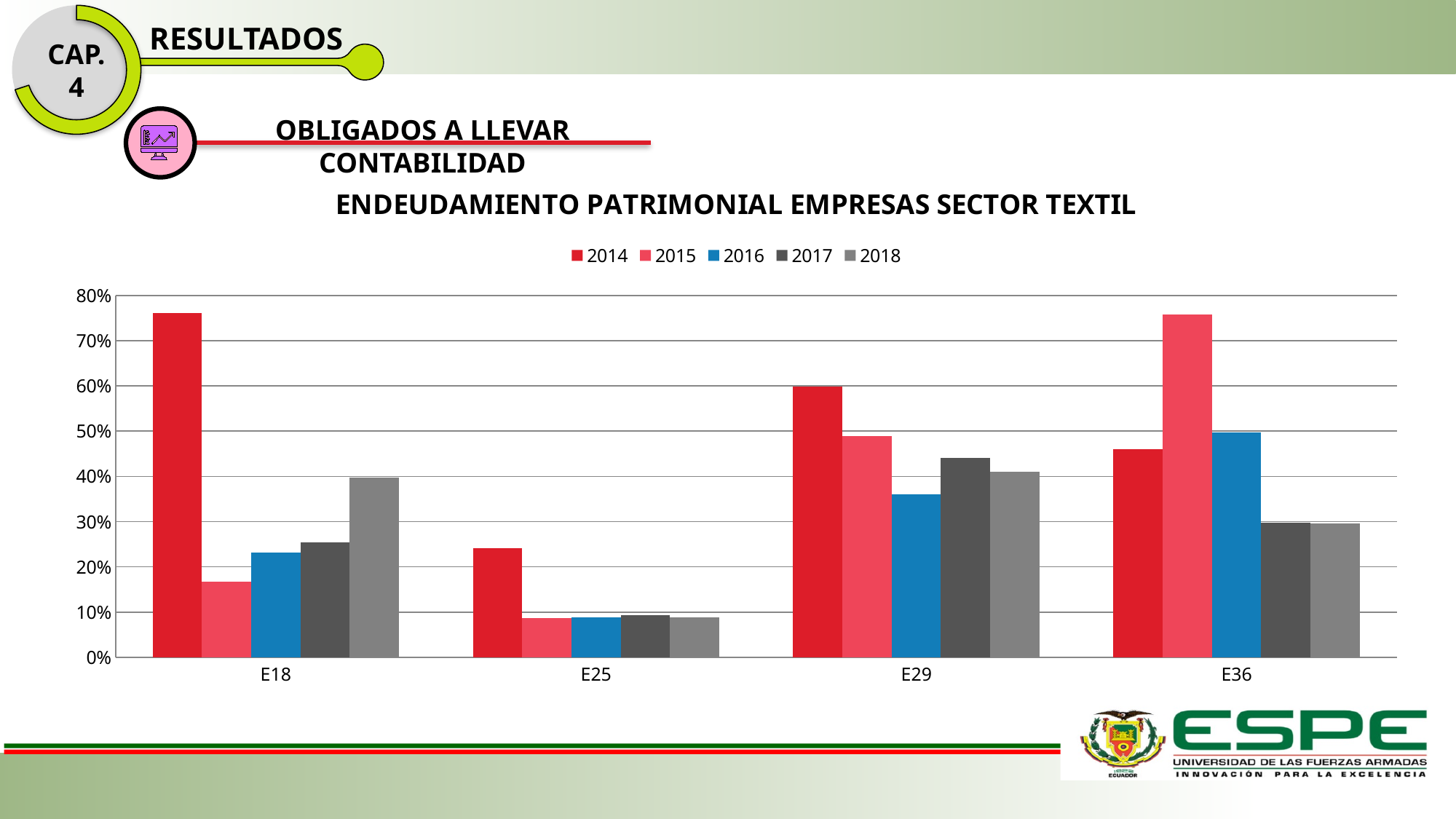
How many series does the legend list? 5 Which company has the highest 2015 value? E36 For E36, which is larger: the 2014 value or the 2015 value? 2015 Which company has the lowest 2014 value? E25 How many companies (categories) are shown on the x axis? 4 Is the 2014 value for E25 greater or less than 30%? less What is the title of the chart? ENDEUDAMIENTO PATRIMONIAL EMPRESAS SECTOR TEXTIL Which company has the highest 2014 value? E18 For E29, which is larger: the 2016 value or the 2017 value? 2017 Is the 2014 value for E29 greater or less than 50%? greater Is the 2014 value for E18 greater or less than 70%? greater What kind of chart is shown on the slide? bar chart